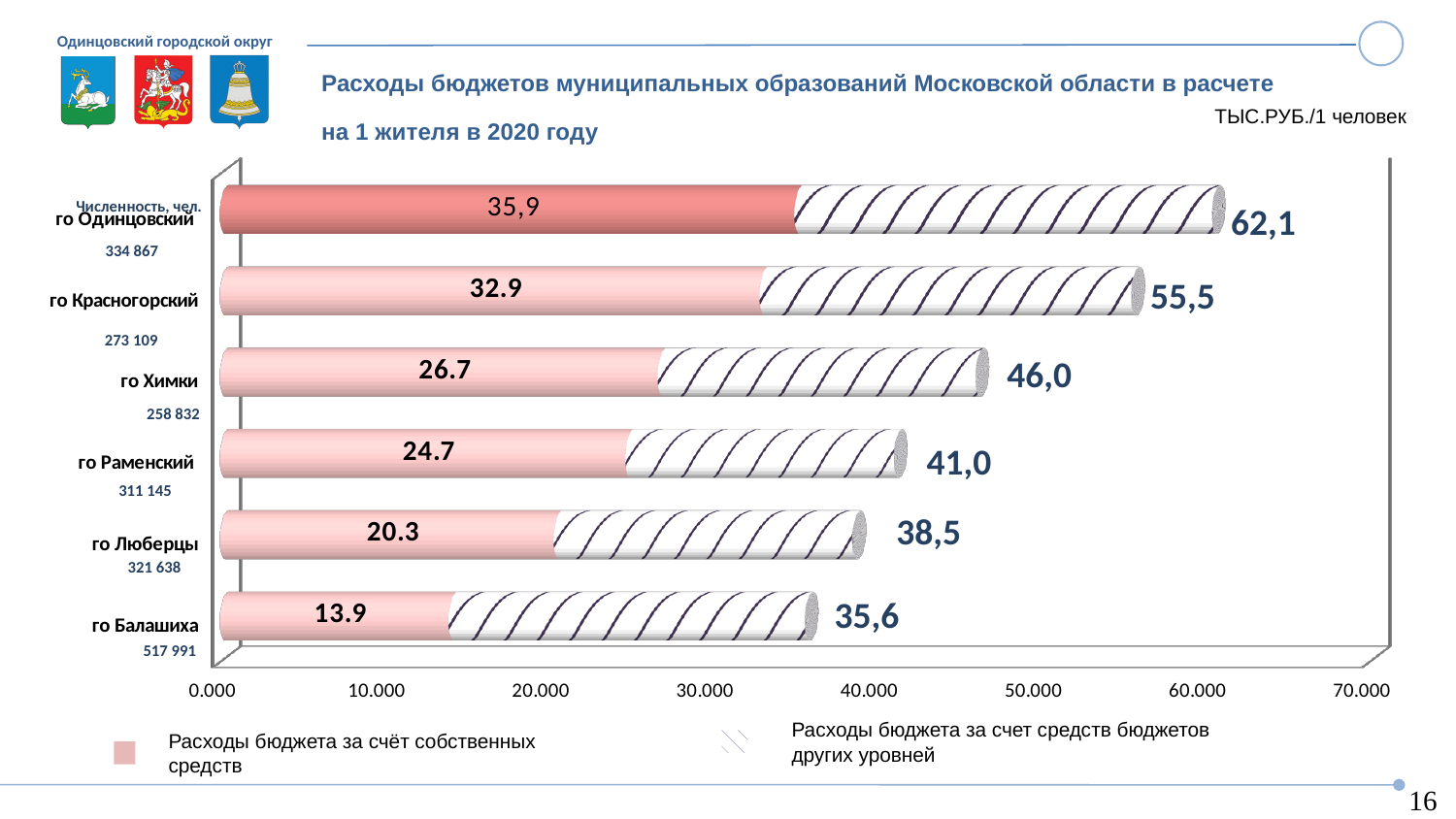
What is the value of expenditure from own funds (Расходы бюджета за счёт собственных средств) for го Химки? 26.7 How many municipalities (categories) are shown in the chart? 6 What is the difference between the total expenditure of го Одинцовский (62,1) and го Красногорский (55,5)? 6,6 Is the total value for го Химки greater or less than 40.000? greater Which municipality has the highest total expenditure per resident? го Одинцовский Which municipality has the lowest expenditure from own funds? го Балашиха Which is larger: the own-funds expenditure of го Раменский or го Люберцы? го Раменский What unit of measurement is indicated for the chart values? ТЫС.РУБ./1 человек What type of chart is shown on the slide? Bar chart How many series does the legend list? 2 What is the total value shown for го Балашиха? 35,6 What is the total budget expenditure per resident for го Одинцовский? 62,1